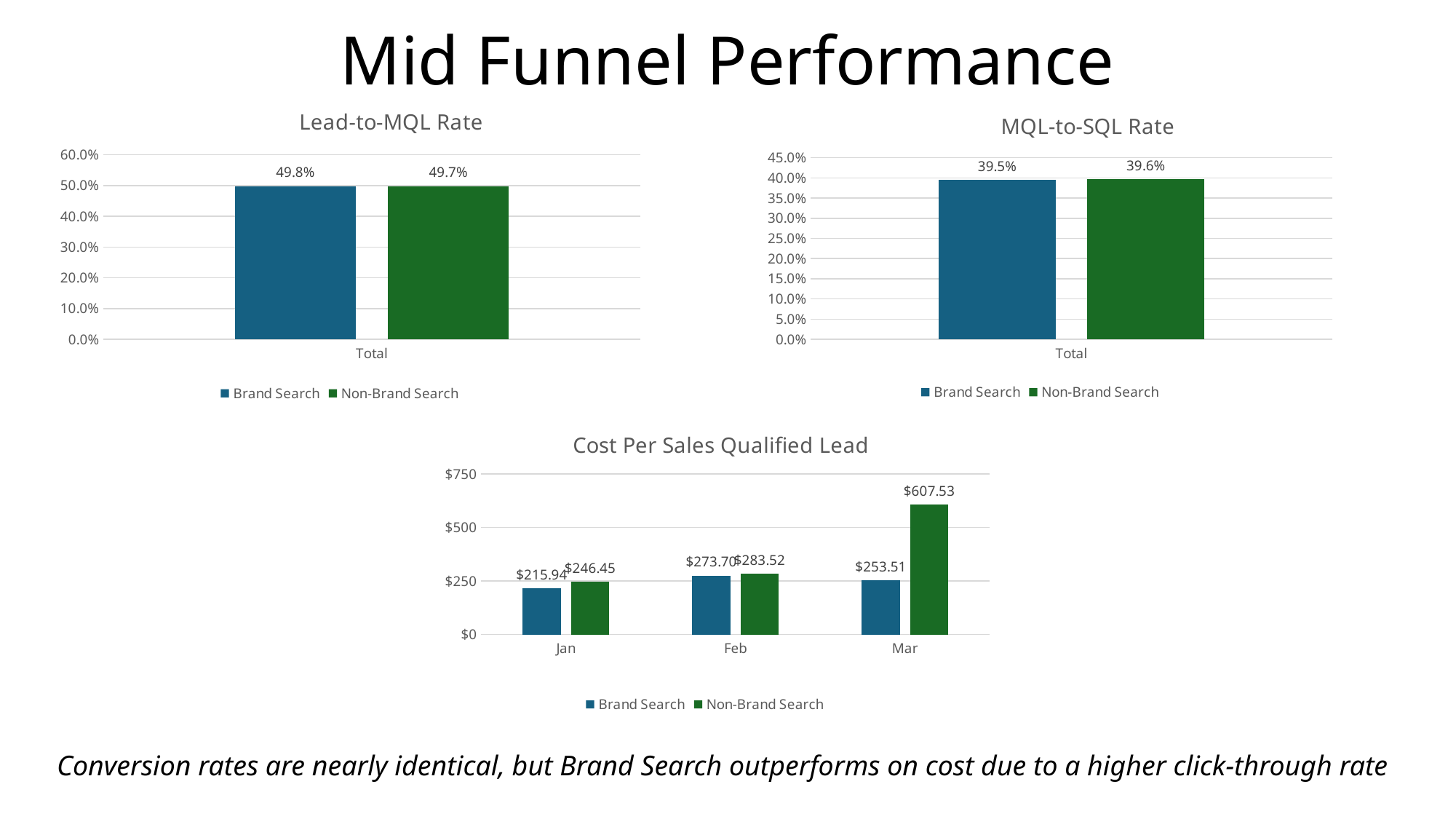
In the Cost Per Sales Qualified Lead chart, which month has the highest Non-Brand Search cost? Mar In the Cost Per Sales Qualified Lead chart, what is the Brand Search value for Jan? $215.94 In the Lead-to-MQL Rate chart, what is the value for Non-Brand Search? 49.7% In the Cost Per Sales Qualified Lead chart, is the Non-Brand Search value for Mar greater or less than $500? greater In the MQL-to-SQL Rate chart, what is the value for Brand Search? 39.5% In the Cost Per Sales Qualified Lead chart, what is the Non-Brand Search value for Mar? $607.53 In the Lead-to-MQL Rate chart, what is the value for Brand Search? 49.8% In the Cost Per Sales Qualified Lead chart, what is the difference between the Non-Brand Search and Brand Search values for Mar? $354.02 In the MQL-to-SQL Rate chart, what is the value for Non-Brand Search? 39.6% How many series does the legend of the MQL-to-SQL Rate chart list? 2 How many months are shown on the x axis of the Cost Per Sales Qualified Lead chart? 3 In the Cost Per Sales Qualified Lead chart, which month has the lowest Brand Search cost? Jan